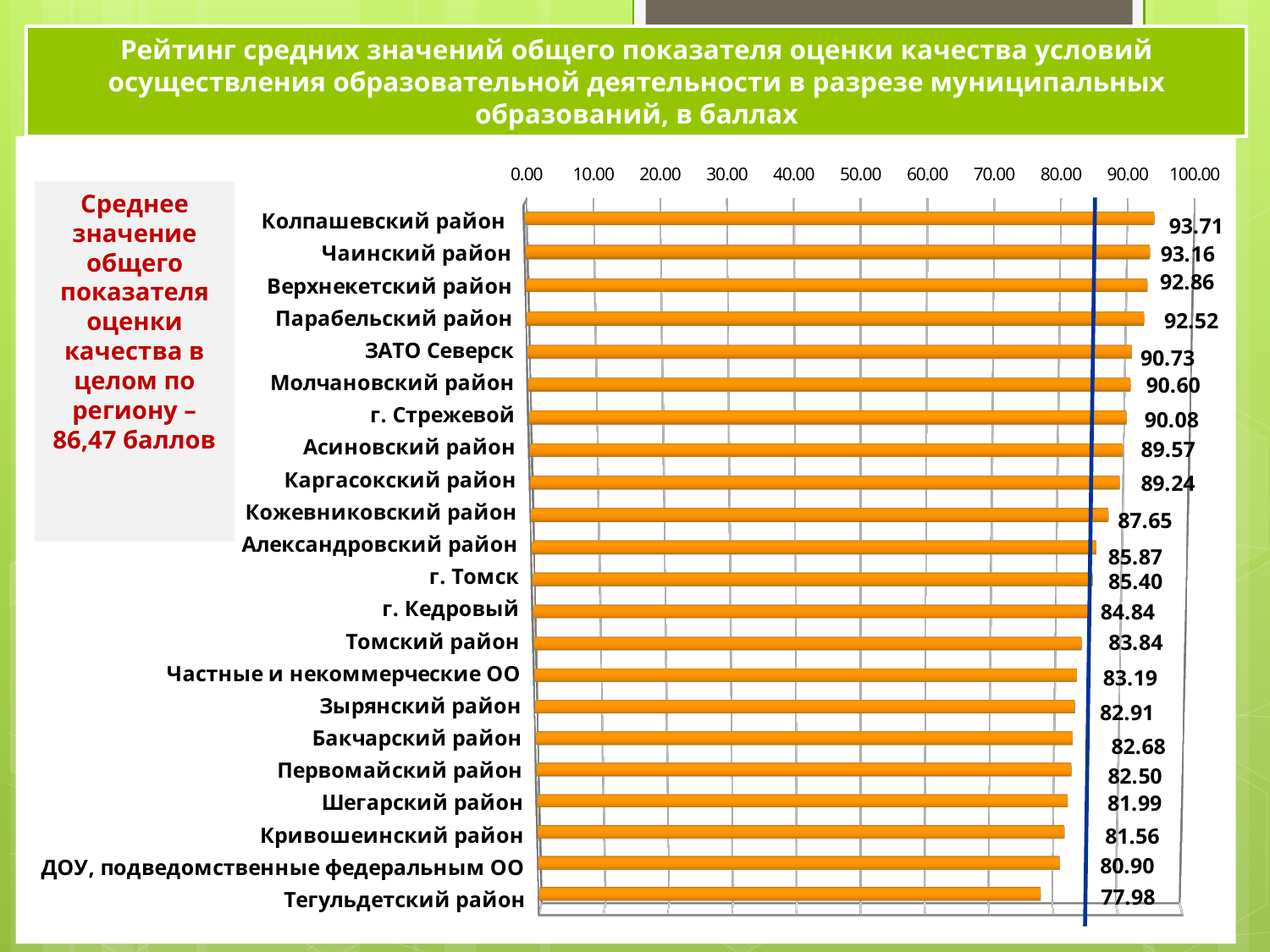
Which category has the lowest value? Тегульдетский район Is the value for Кожевниковский район greater or less than 90.00? less What is the difference between the values for Томский район and Зырянский район? 0.93 Which is larger, the value for ЗАТО Северск or the value for г. Стрежевой? ЗАТО Северск What is the difference between the values for Колпашевский район and Тегульдетский район? 15.73 What is the value for г. Томск? 85.40 What regional average value is stated in the text box to the left of the chart? 86,47 баллов How many categories are shown in the chart? 22 What kind of chart is shown on the slide? bar chart Which category has the highest value? Колпашевский район What is the value for ДОУ, подведомственные федеральным ОО? 80.90 What is the value for Колпашевский район? 93.71